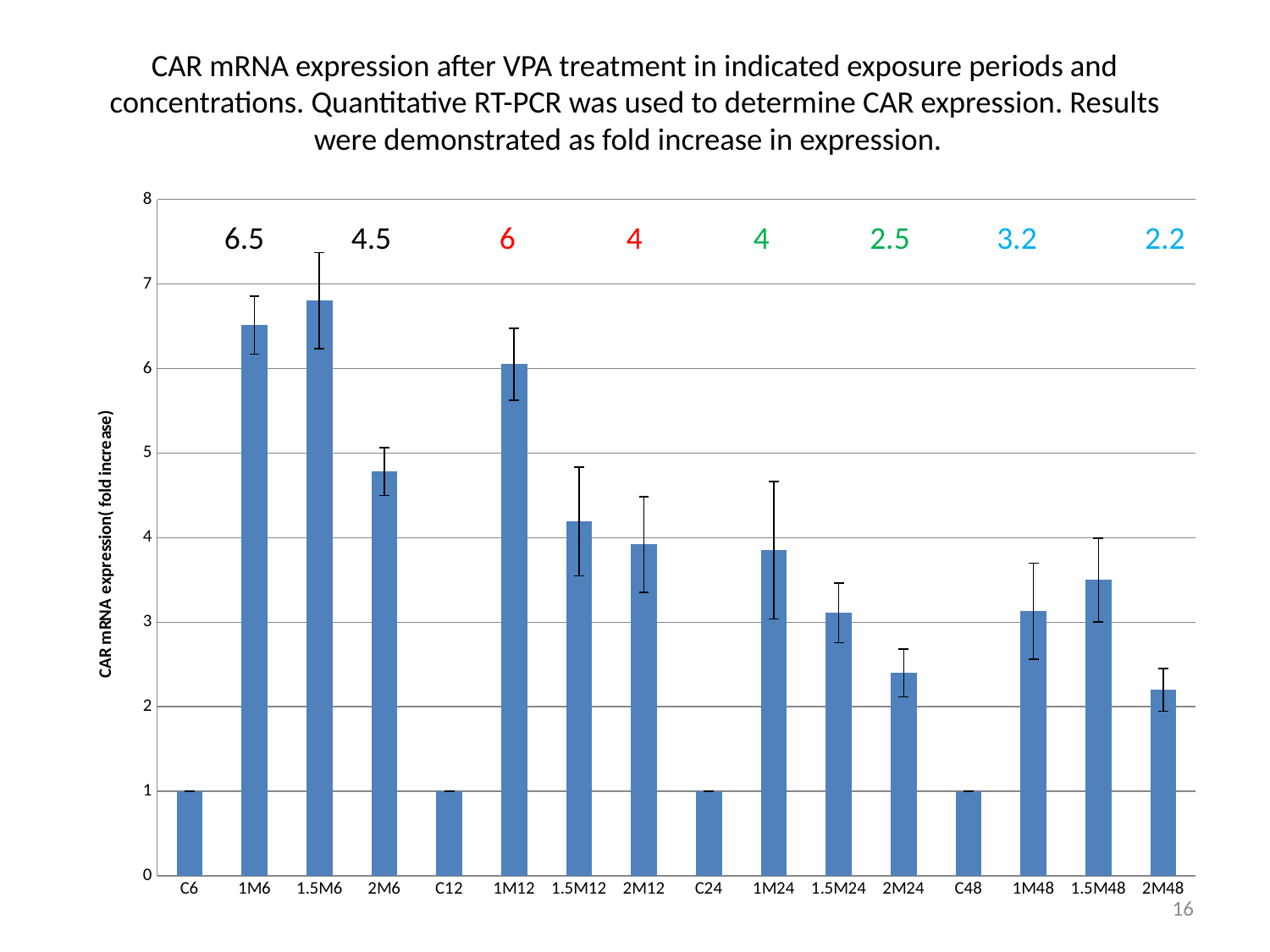
Is the value for 1M6 greater or less than 6? greater Is the value for 2M24 greater or less than 3? less What is the value for C48? 1 What is the value for C6? 1 Which is larger, the value for 1M12 or the value for 2M12? 1M12 What kind of chart is shown on the slide? bar chart Do the values for the 1M bars (1M6, 1M12, 1M24, 1M48) rise or fall from left to right? fall Which category has the highest bar? 1.5M6 Is the value for 1.5M48 greater or less than 3? greater What is the label on the y axis of the chart? CAR mRNA expression( fold increase) How many categories are shown on the x axis of the chart? 16